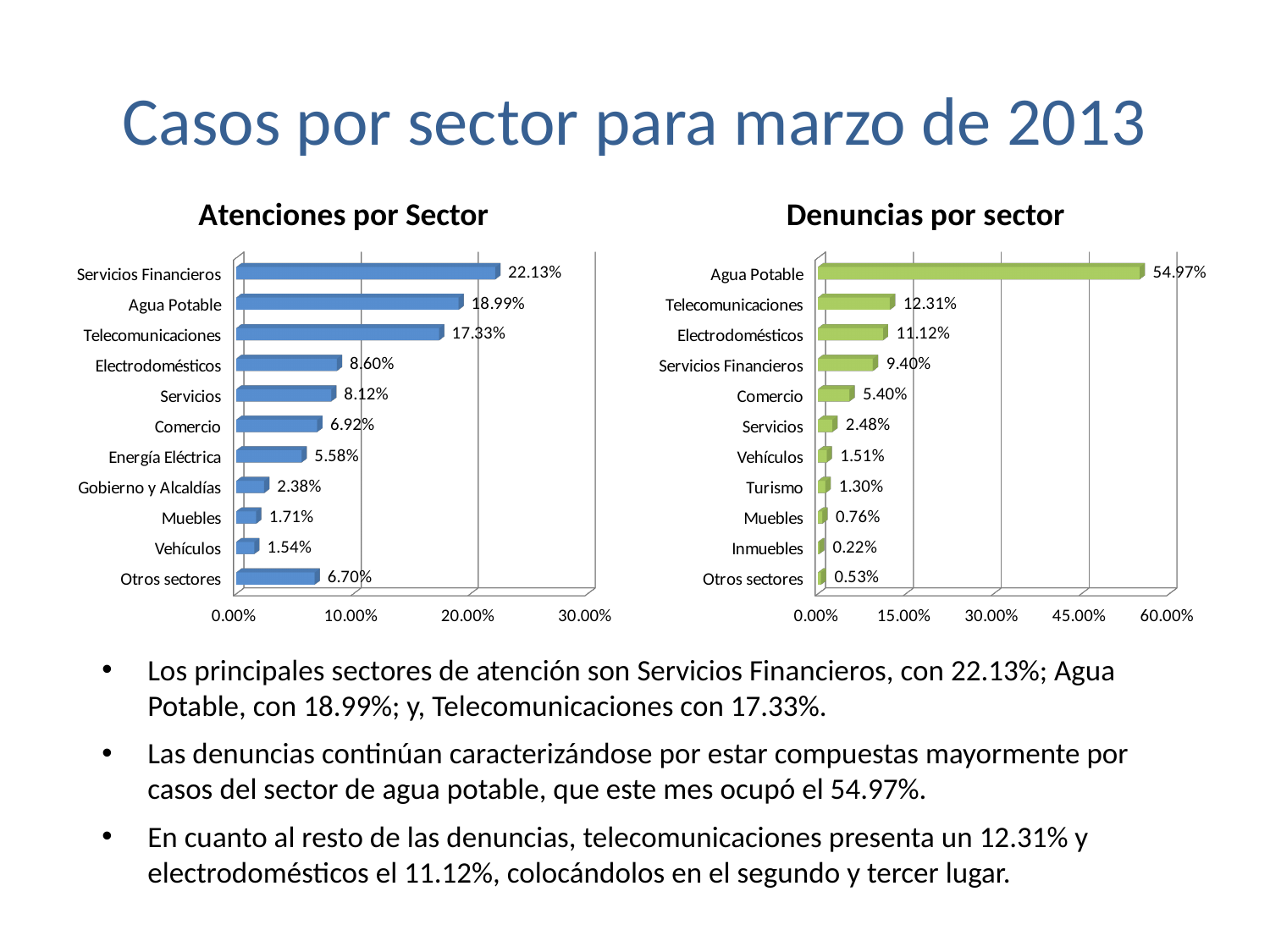
In the 'Atenciones por Sector' chart, which sector has the lowest value? Vehículos What kind of chart is 'Atenciones por Sector'? Bar chart In the 'Atenciones por Sector' chart, which sector has the highest value? Servicios Financieros In the 'Denuncias por sector' chart, what is the value for Comercio? 5.40% In the 'Denuncias por sector' chart, is the value for Agua Potable greater or less than 45.00%? greater What colour are the bars in the 'Denuncias por sector' chart? Green In the 'Atenciones por Sector' chart, what is the difference between Servicios Financieros and Agua Potable? 3.14% How many sectors are shown in the 'Denuncias por sector' chart? 11 In the 'Atenciones por Sector' chart, what is the value for Electrodomésticos? 8.60% In the 'Denuncias por sector' chart, which sector has the lowest value? Inmuebles In the 'Atenciones por Sector' chart, which is larger: Comercio or Otros sectores? Comercio In the 'Denuncias por sector' chart, what is the difference between Agua Potable and Telecomunicaciones? 42.66%